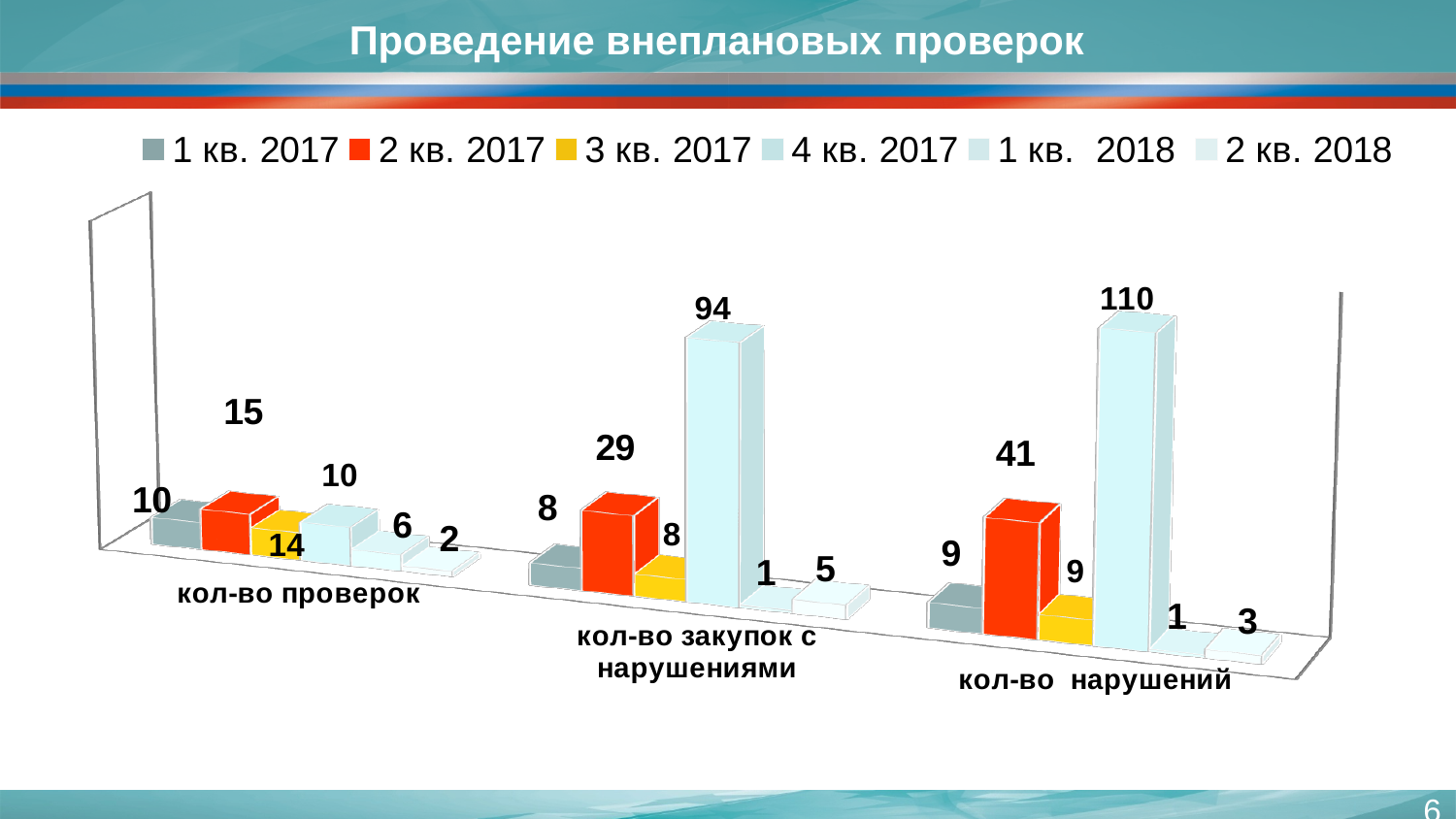
Which series has the highest value in the category кол-во нарушений? 4 кв. 2017 What is the difference between the 4 кв. 2017 values for кол-во нарушений and кол-во закупок с нарушениями? 16 How many categories are shown on the x axis? 3 What is the title of the chart? Проведение внеплановых проверок What type of chart is shown on the slide? bar chart How many series does the legend list? 6 Which is larger in the category кол-во проверок: the value for 2 кв. 2017 or the value for 3 кв. 2017? 2 кв. 2017 What is the value for 2 кв. 2018 in the category кол-во проверок? 2 What is the value for 2 кв. 2017 in the category кол-во проверок? 15 What is the value for 4 кв. 2017 in the category кол-во нарушений? 110 What is the value for 4 кв. 2017 in the category кол-во закупок с нарушениями? 94 Which series has the lowest value in the category кол-во закупок с нарушениями? 1 кв. 2018